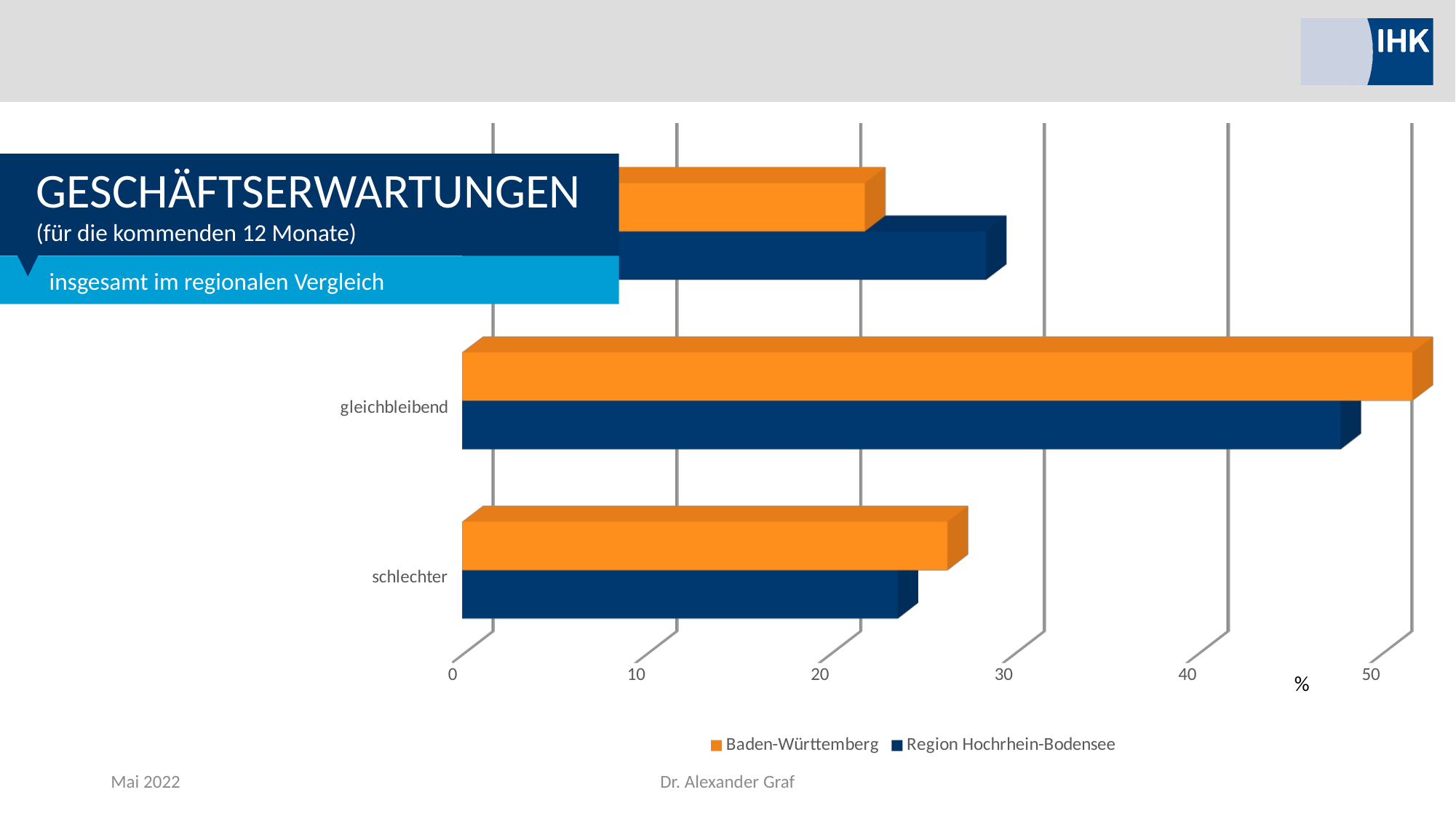
Is the value for Region Hochrhein-Bodensee in the category 'schlechter' greater or less than 20? greater Is the value for Region Hochrhein-Bodensee in the category 'gleichbleibend' greater or less than 40? greater What kind of chart is shown on the slide? bar chart Which series is shown in orange? Baden-Württemberg In the category 'schlechter', which series has the larger value, Baden-Württemberg or Region Hochrhein-Bodensee? Baden-Württemberg What unit is shown on the horizontal axis? % How many series does the legend list? 2 Is the value for Baden-Württemberg in the category 'schlechter' greater or less than 30? less Which category has the highest value for Region Hochrhein-Bodensee? gleichbleibend How many categories are plotted in the chart? 3 In the category 'gleichbleibend', which series has the larger value, Baden-Württemberg or Region Hochrhein-Bodensee? Baden-Württemberg